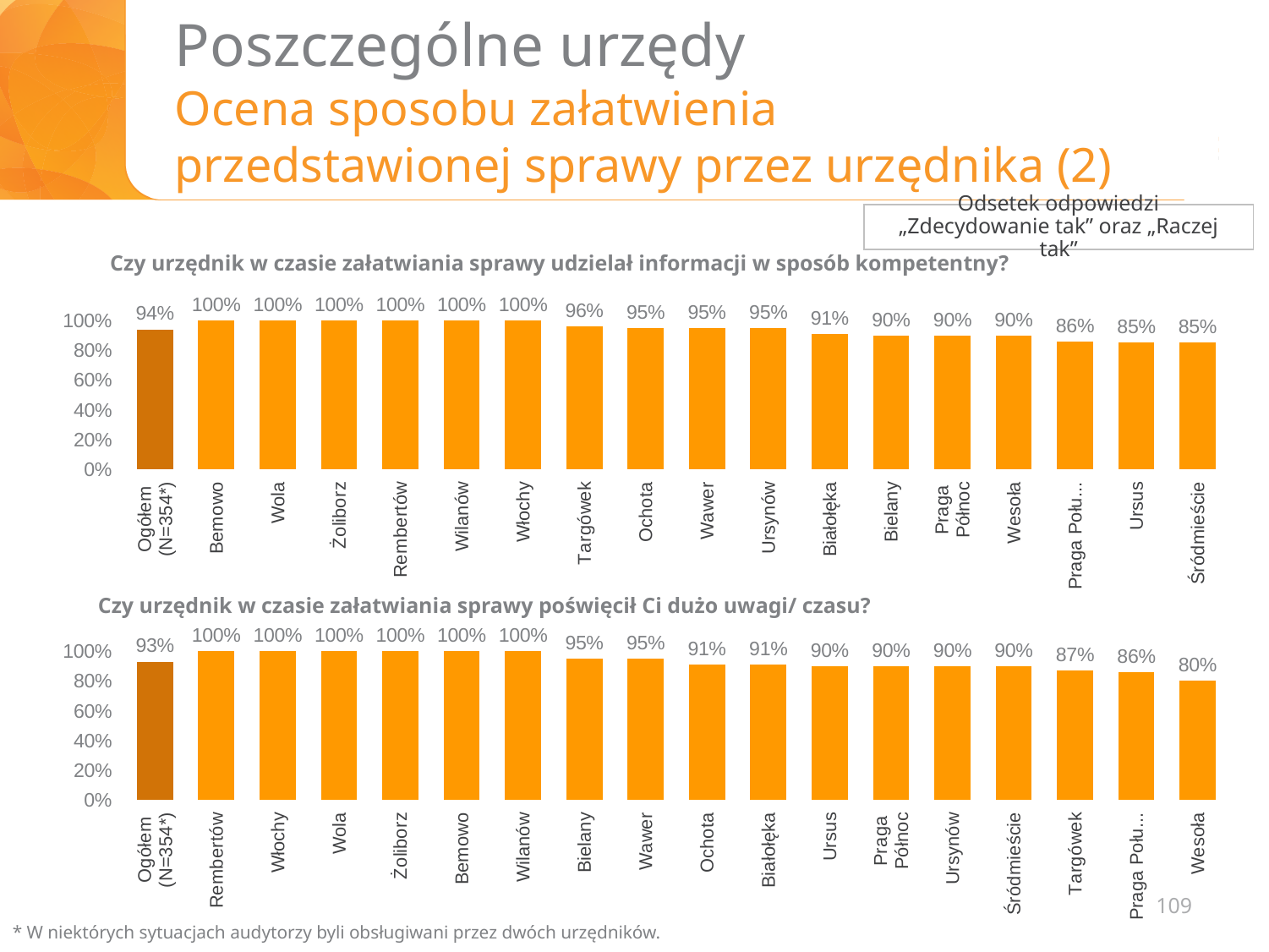
In the bottom chart ("Czy urzędnik w czasie załatwiania sprawy poświęcił Ci dużo uwagi/ czasu?"), which category has the lowest value? Wesoła In the bottom chart ("Czy urzędnik w czasie załatwiania sprawy poświęcił Ci dużo uwagi/ czasu?"), what is the difference between the values for Ogółem (N=354*) and Wesoła? 13 percentage points In the top chart ("Czy urzędnik w czasie załatwiania sprawy udzielał informacji w sposób kompetentny?"), what is the value for Ogółem (N=354*)? 94% How many bars are shown in the top chart ("Czy urzędnik w czasie załatwiania sprawy udzielał informacji w sposób kompetentny?")? 18 In the bottom chart ("Czy urzędnik w czasie załatwiania sprawy poświęcił Ci dużo uwagi/ czasu?"), what is the value for Targówek? 87% In the top chart ("Czy urzędnik w czasie załatwiania sprawy udzielał informacji w sposób kompetentny?"), what is the value for Białołęka? 91% In the bottom chart ("Czy urzędnik w czasie załatwiania sprawy poświęcił Ci dużo uwagi/ czasu?"), what is the value for Ogółem (N=354*)? 93% In the bottom chart ("Czy urzędnik w czasie załatwiania sprawy poświęcił Ci dużo uwagi/ czasu?"), which is larger: the value for Bielany or the value for Ursus? Bielany In the top chart ("Czy urzędnik w czasie załatwiania sprawy udzielał informacji w sposób kompetentny?"), which is larger: the value for Ochota or the value for Bielany? Ochota In the top chart ("Czy urzędnik w czasie załatwiania sprawy udzielał informacji w sposób kompetentny?"), what is the value for Targówek? 96% In the top chart ("Czy urzędnik w czasie załatwiania sprawy udzielał informacji w sposób kompetentny?"), do the values generally rise or fall from left to right after the Ogółem bar? Fall What type of chart is the bottom chart ("Czy urzędnik w czasie załatwiania sprawy poświęcił Ci dużo uwagi/ czasu?")? Bar chart